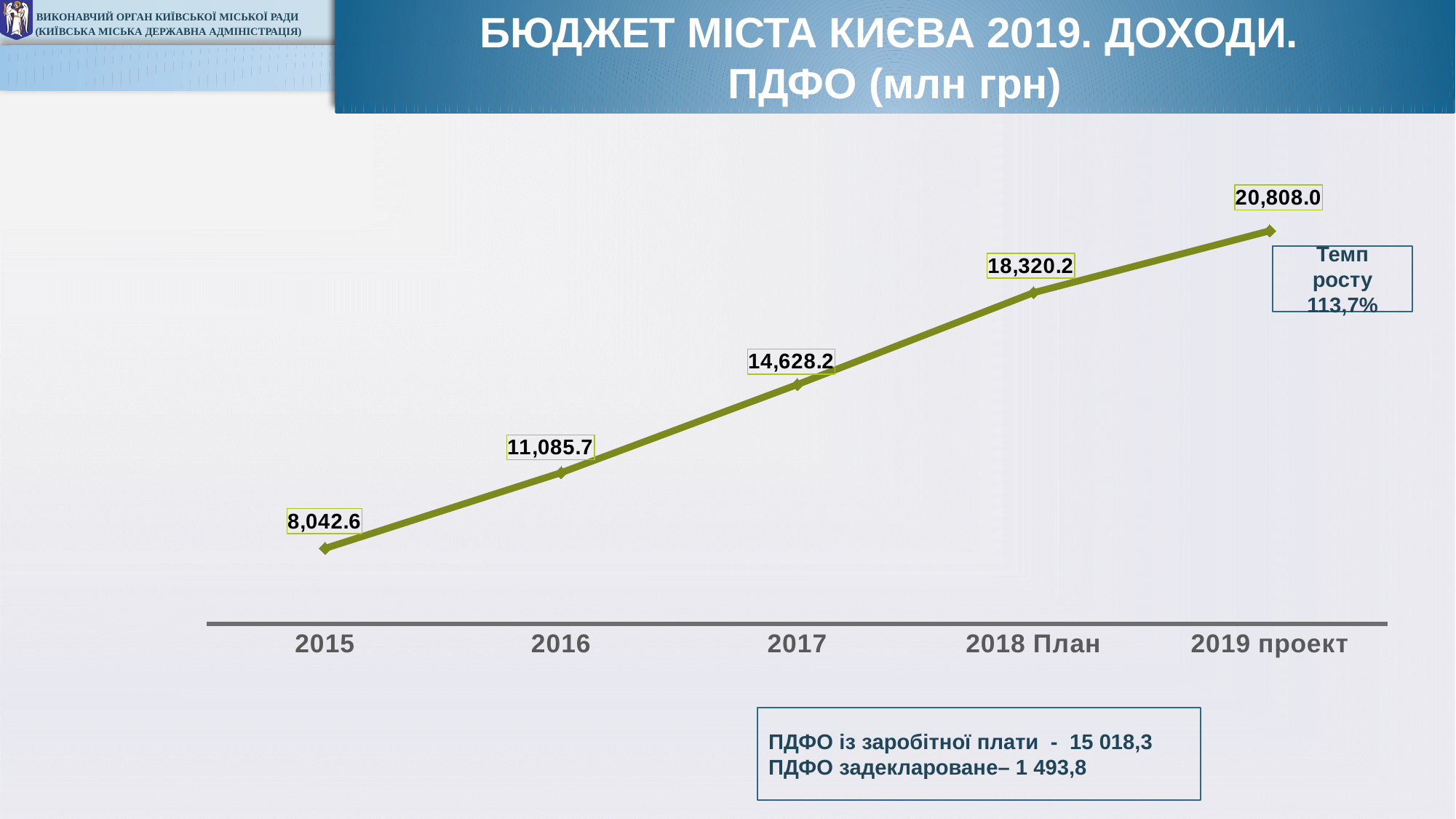
Which year has the lowest value? 2015 What is the value for 2015? 8,042.6 What is the value for 2016? 11,085.7 How many data points are plotted on the chart? 5 What is the difference between the values for 2016 and 2015? 3,043.1 What is the difference between the values for 2019 проект and 2018 План? 2,487.8 What is the value for 2018 План? 18,320.2 What kind of chart is shown on the slide? line chart Which is larger, the value for 2017 or the value for 2016? 2017 What is the value for 2019 проект? 20,808.0 Which year has the highest value? 2019 проект What is the value for 2017? 14,628.2